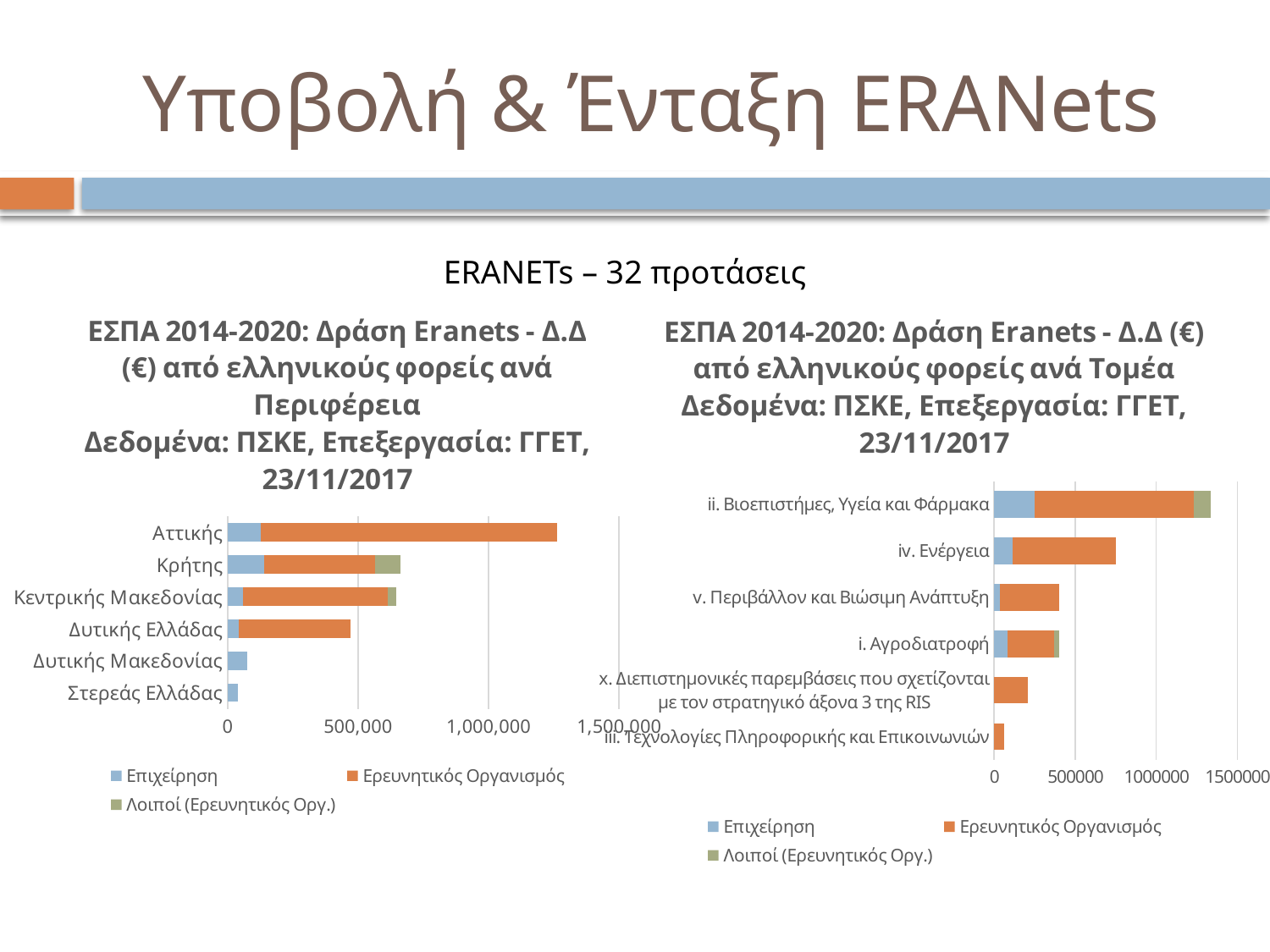
How many regions are shown on the left chart (Δ.Δ ανά Περιφέρεια)? 6 On the right chart (Δ.Δ ανά Τομέα), which sector has the highest total value? ii. Βιοεπιστήμες, Υγεία και Φάρμακα On the right chart (Δ.Δ ανά Τομέα), is the total value for iv. Ενέργεια greater or less than 500000? greater How many series does the legend of the left chart (Δ.Δ ανά Περιφέρεια) list? 3 Which series is shown in orange in the legend of the right chart (Δ.Δ ανά Τομέα)? Ερευνητικός Οργανισμός What kind of chart is the left chart (Δ.Δ ανά Περιφέρεια)? stacked bar chart On the left chart (Δ.Δ ανά Περιφέρεια), which has the larger total value, Αττικής or Κρήτης? Αττικής On the left chart (Δ.Δ ανά Περιφέρεια), which region has the lowest total value? Στερεάς Ελλάδας On the left chart (Δ.Δ ανά Περιφέρεια), is the total value for Αττικής greater or less than 1,000,000? greater How many sectors are shown on the right chart (Δ.Δ ανά Τομέα)? 6 On the left chart (Δ.Δ ανά Περιφέρεια), is the total value for Δυτικής Ελλάδας greater or less than 500,000? less On the left chart (Δ.Δ ανά Περιφέρεια), which region has the highest total value? Αττικής